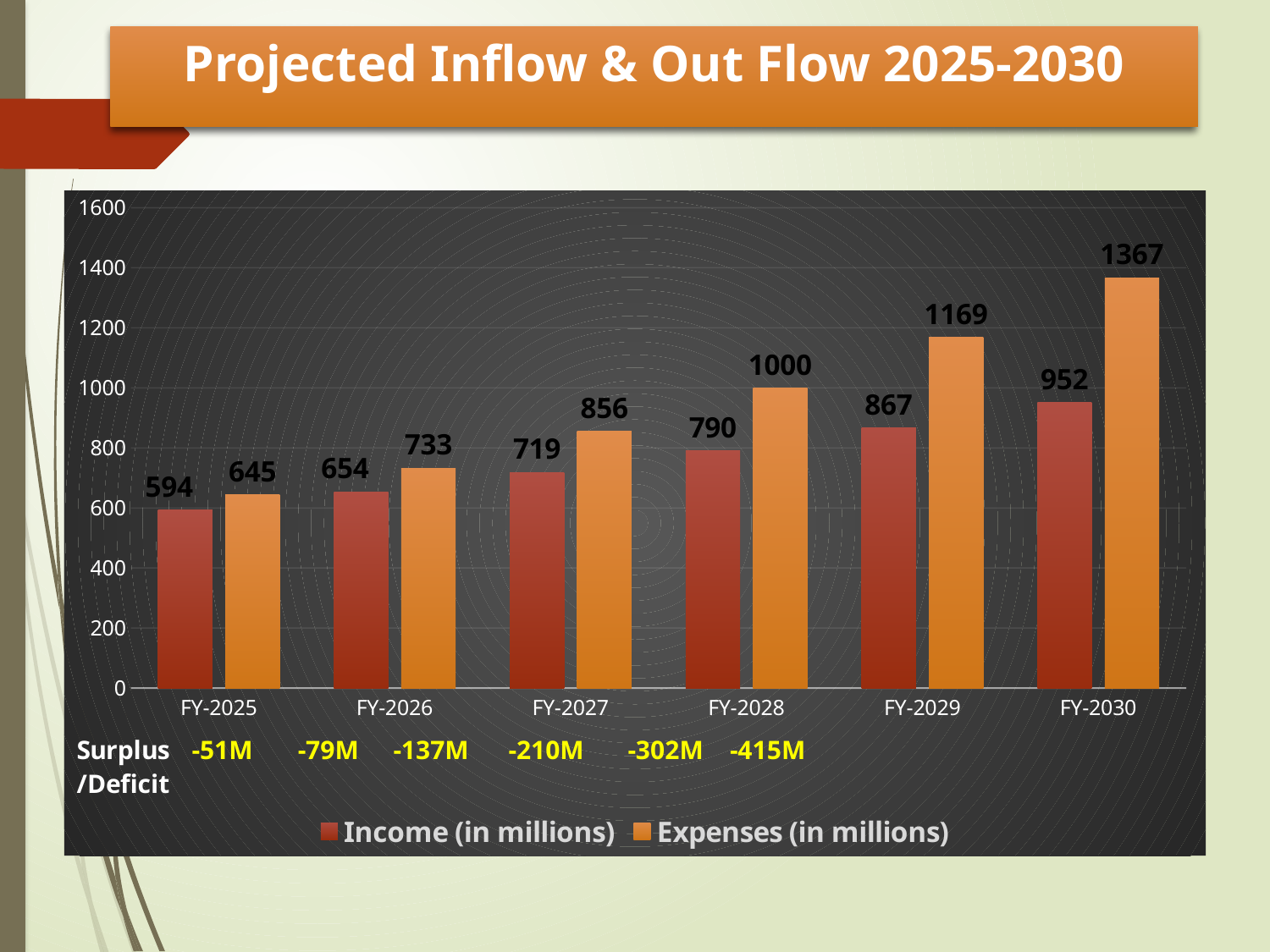
What is the Income (in millions) value for FY-2027? 719 Which is larger for FY-2026: Income or Expenses? Expenses Which fiscal year has the lowest Income (in millions) value? FY-2025 How many fiscal years are shown on the x axis? 6 What is the Expenses (in millions) value for FY-2029? 1169 Is the Expenses value for FY-2030 greater or less than 1200? greater Do the Income values rise or fall from FY-2025 to FY-2030? rise Which fiscal year has the highest Expenses (in millions) value? FY-2030 What is the title of the chart? Projected Inflow & Out Flow 2025-2030 What kind of chart is shown on the slide? bar chart What is the difference between Expenses and Income for FY-2028? 210 How many series does the legend list? 2